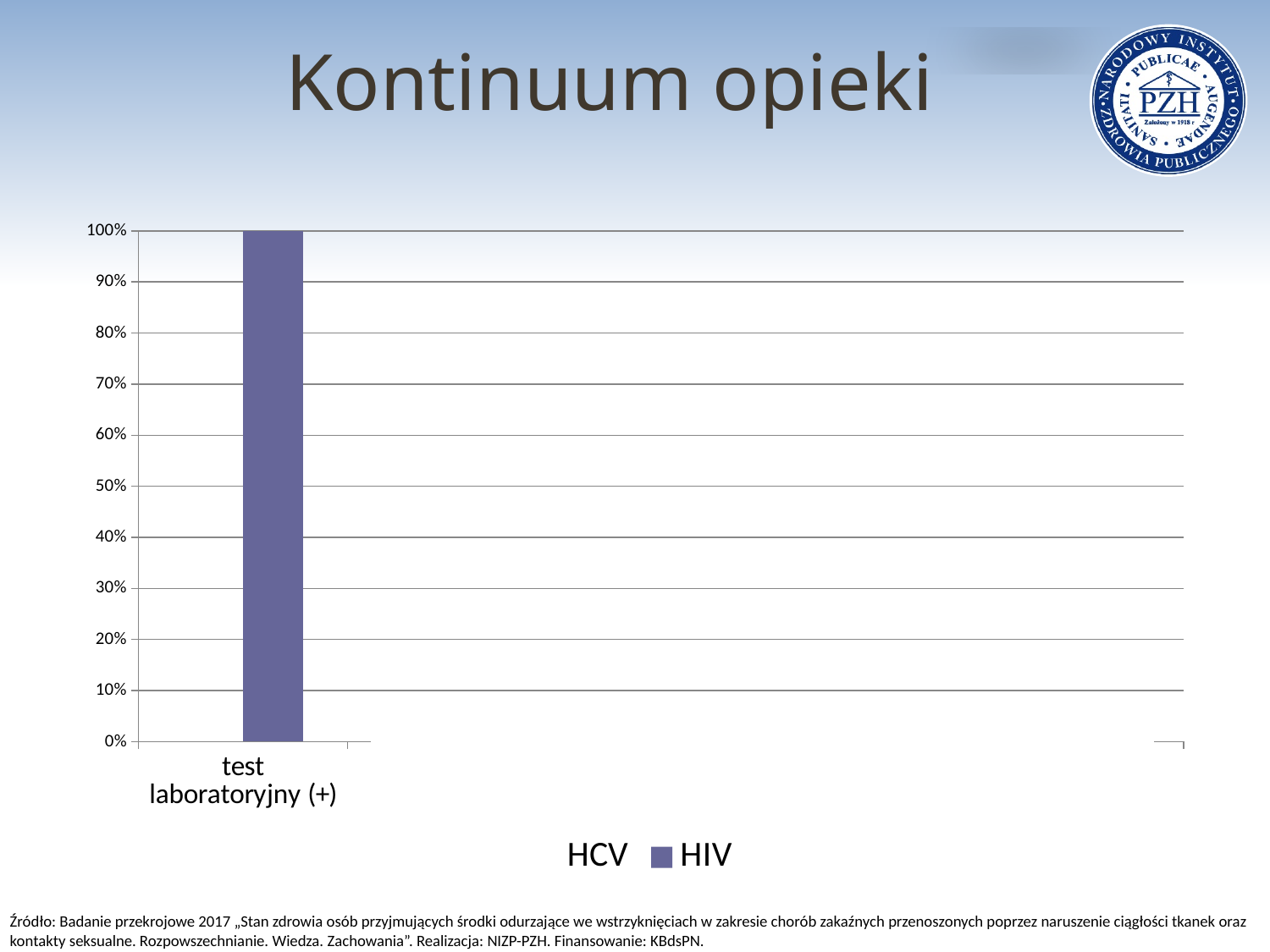
Is the value of the bar for 'test laboratoryjny (+)' greater or less than 90%? greater What is the title of the slide containing the chart? Kontinuum opieki What kind of chart is shown on the slide? bar chart What is the label of the category with the visible bar? test laboratoryjny (+) Which series are listed in the legend? HCV and HIV What is the highest value shown on the y axis of the chart? 100% How many category labels are readable on the x axis of the chart? 1 How many series does the legend list? 2 Is the value of the bar for 'test laboratoryjny (+)' greater or less than 50%? greater What is the value of the HIV bar for the category 'test laboratoryjny (+)'? 100%